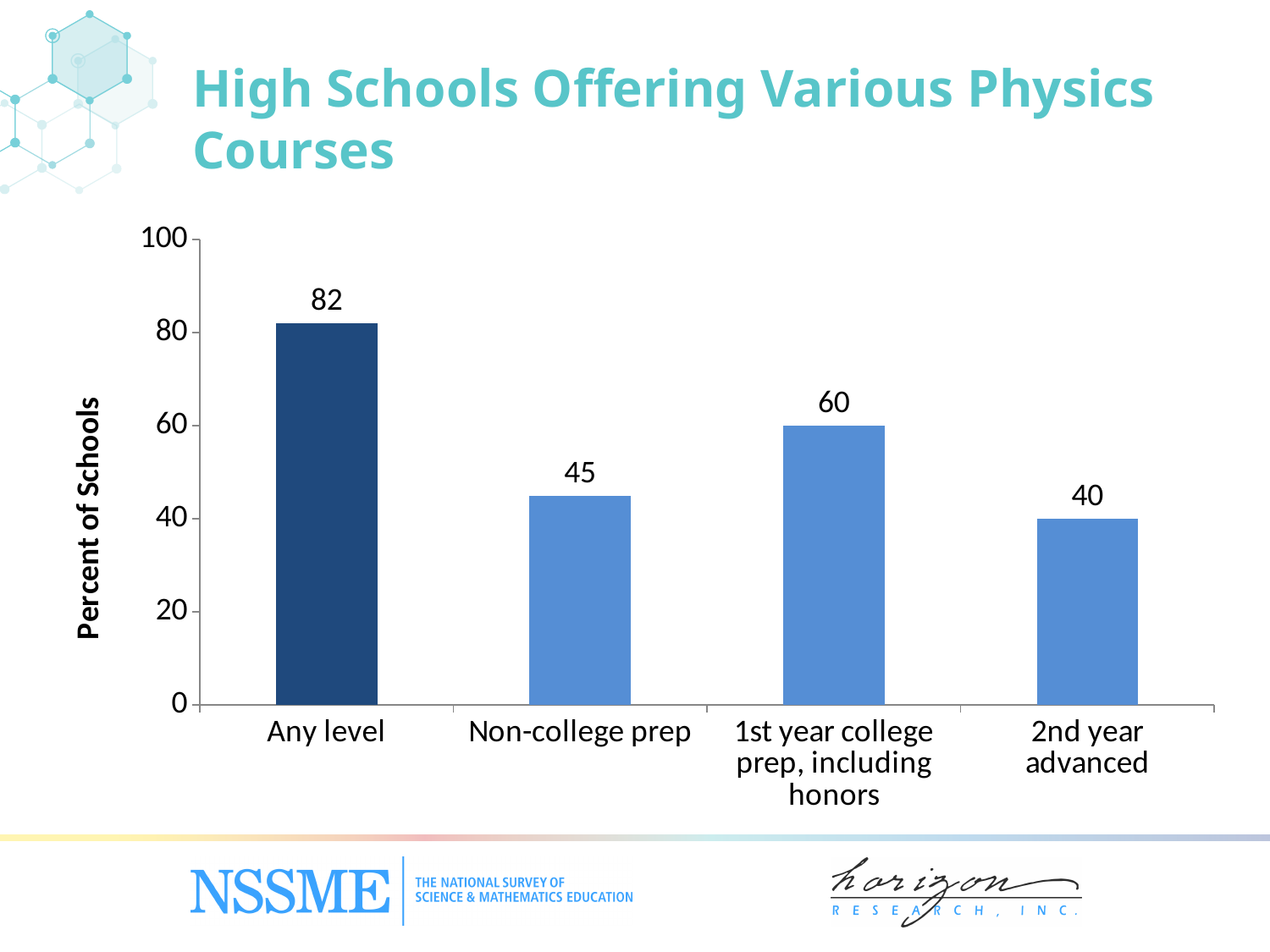
What kind of chart is shown on the slide? Bar chart Which category has the highest percent of schools? Any level What is the difference between the values for 1st year college prep, including honors and 2nd year advanced? 20 What is the value for 2nd year advanced? 40 What is the label of the y axis? Percent of Schools How many categories are shown on the x axis? 4 What percent of schools offer physics at any level? 82 What is the difference between the values for Any level and Non-college prep? 37 What is the value for Non-college prep? 45 Which is larger, the value for Non-college prep or the value for 1st year college prep, including honors? 1st year college prep, including honors What is the value for 1st year college prep, including honors? 60 Which category has the lowest percent of schools? 2nd year advanced